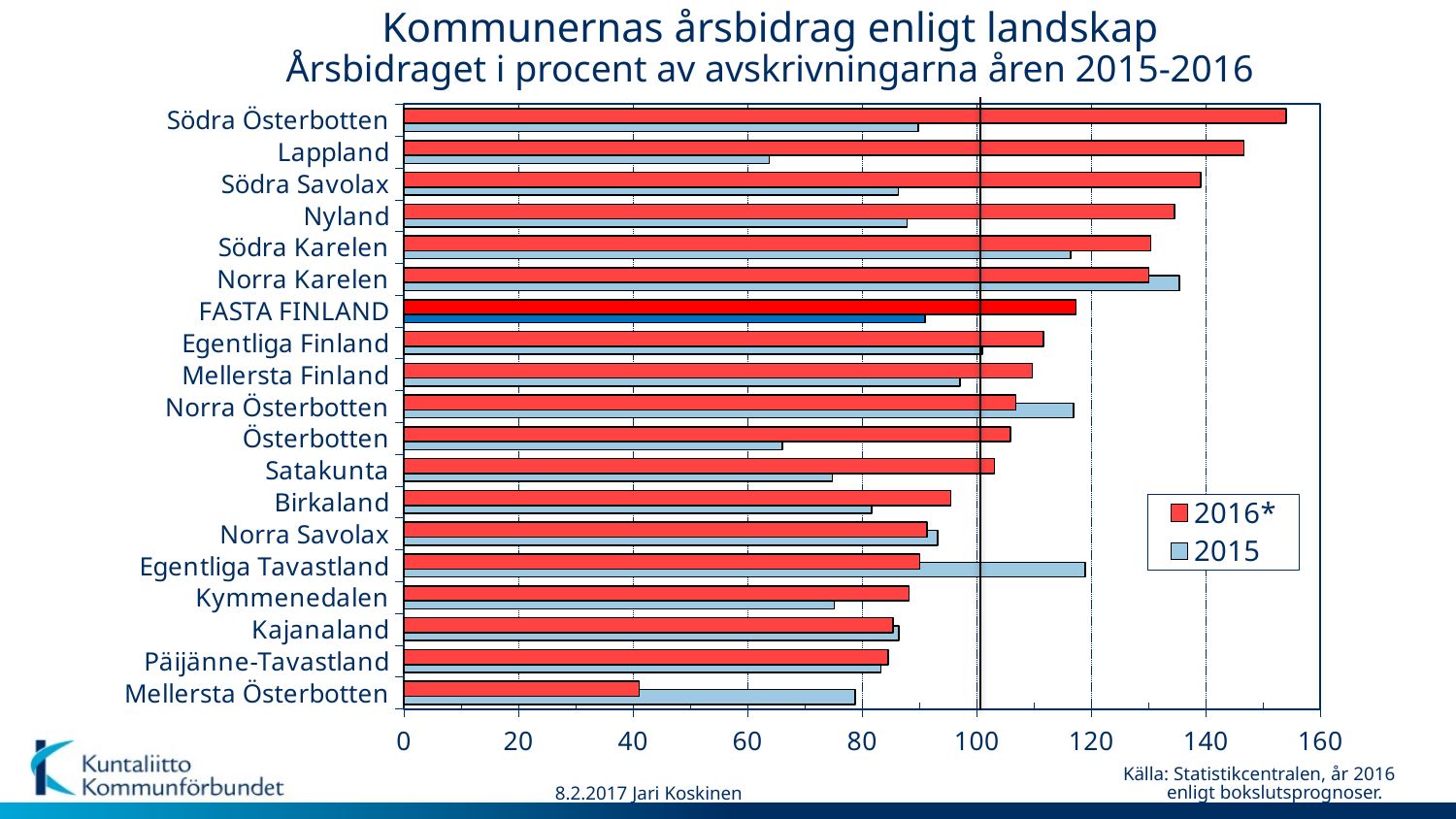
Is the 2015 value for Lappland greater or less than 80? less For Egentliga Tavastland, which series has the larger value, 2016* or 2015? 2015 Which region has the lowest 2016* value? Mellersta Österbotten What kind of chart is shown on the slide? Bar chart Is the 2016* value for Södra Österbotten greater or less than 140? greater How many regions (categories) are shown on the y axis? 19 Which series is shown in red according to the legend? 2016* Which region has the highest 2015 value? Norra Karelen Which region has the highest 2016* value? Södra Österbotten Is the 2016* value for Mellersta Österbotten greater or less than 60? less How many series does the legend list? 2